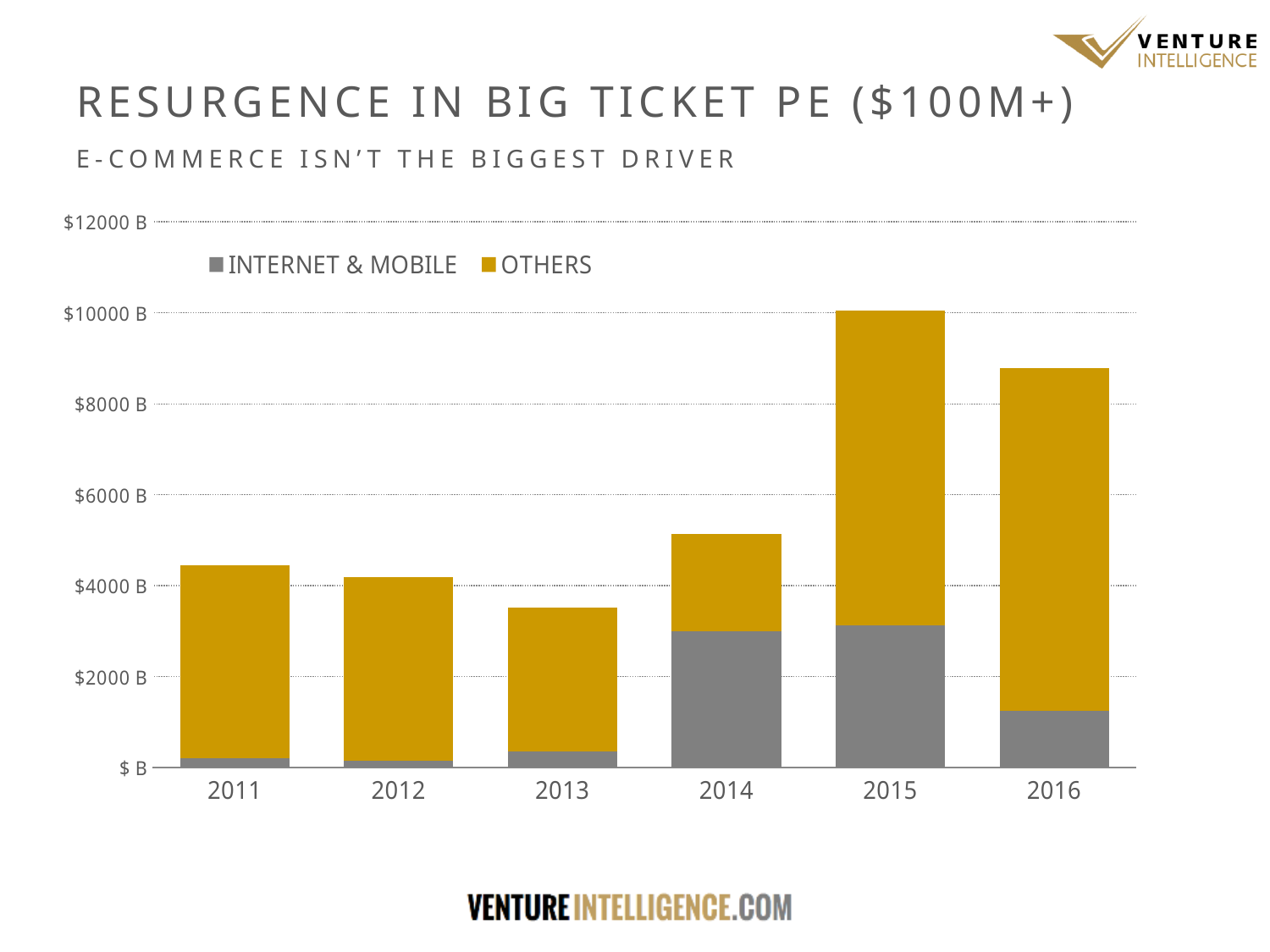
How many years are shown on the x axis of the chart? 6 Which year has the larger total bar, 2015 or 2016? 2015 What kind of chart is shown on the slide? Stacked bar chart Is the total value for 2013 greater or less than $4000 B? less Is the Internet & Mobile value for 2016 greater or less than $2000 B? less How many series does the chart's legend list? 2 Which year has the lowest total bar in the chart? 2013 Is the Internet & Mobile value for 2014 greater or less than $2000 B? greater Do the total bar values rise or fall from 2013 to 2015? rise Which series is shown in grey in the chart's legend? INTERNET & MOBILE Which year has the highest total bar in the chart? 2015